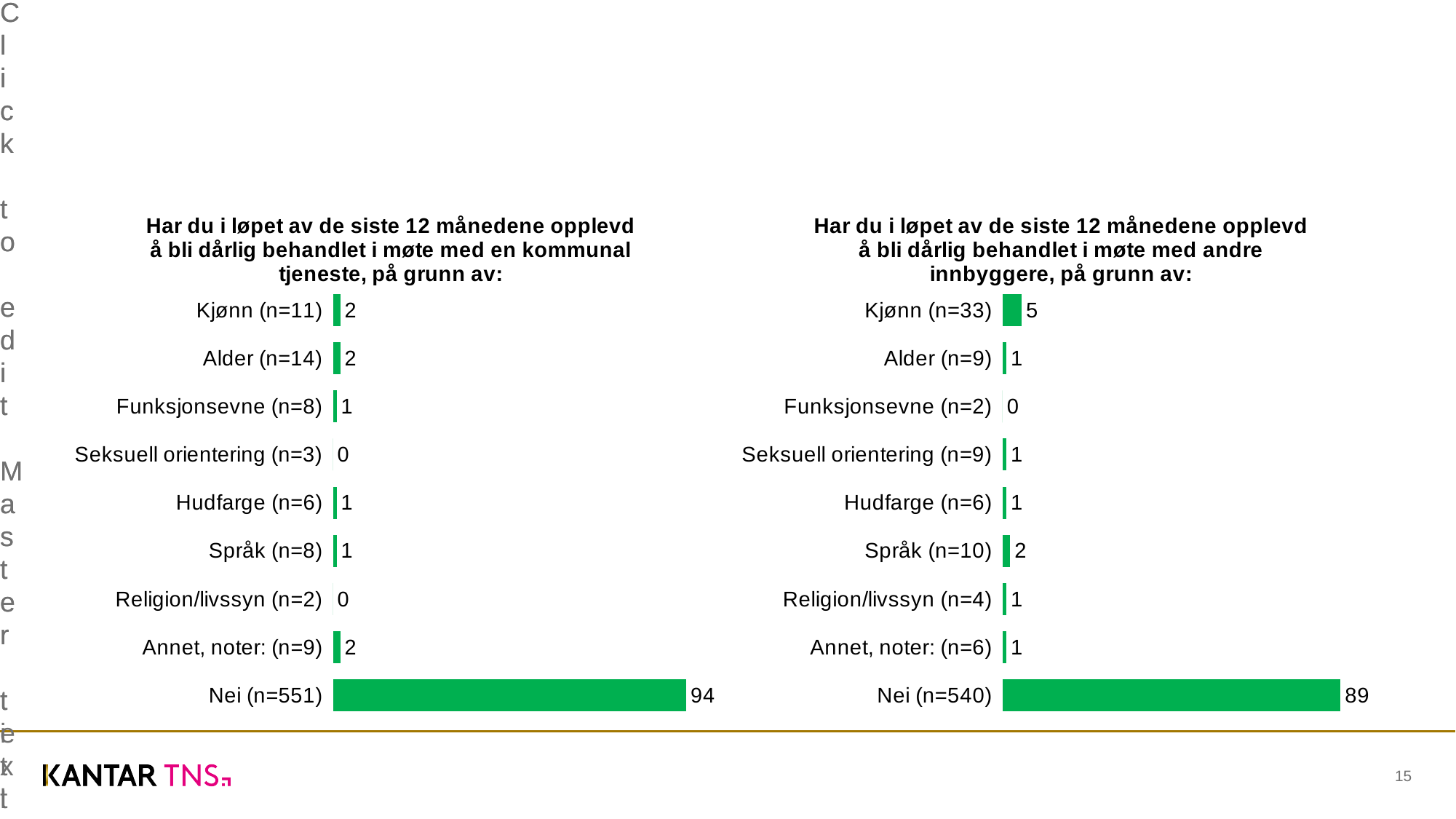
In the left chart (about a kommunal tjeneste), what is the value for Nei (n=551)? 94 In the left chart (about a kommunal tjeneste), what is the value for Funksjonsevne (n=8)? 1 In the right chart (about andre innbyggere), what is the difference between Kjønn (n=33) and Språk (n=10)? 3 In the right chart (about andre innbyggere), what is the value for Kjønn (n=33)? 5 In the right chart (about andre innbyggere), which category has the lowest value? Funksjonsevne (n=2) Which is larger: the Kjønn value in the left chart or the Kjønn value in the right chart? The right chart (Kjønn n=33) In the left chart (about a kommunal tjeneste), which category has the highest value? Nei (n=551) What is the difference between the Nei value in the left chart (94) and the Nei value in the right chart (89)? 5 What colour are the bars in both charts? Green What kind of chart is used on this slide? Bar chart In the right chart (about andre innbyggere), what is the value for Nei (n=540)? 89 How many categories are shown in the left chart (about a kommunal tjeneste)? 9